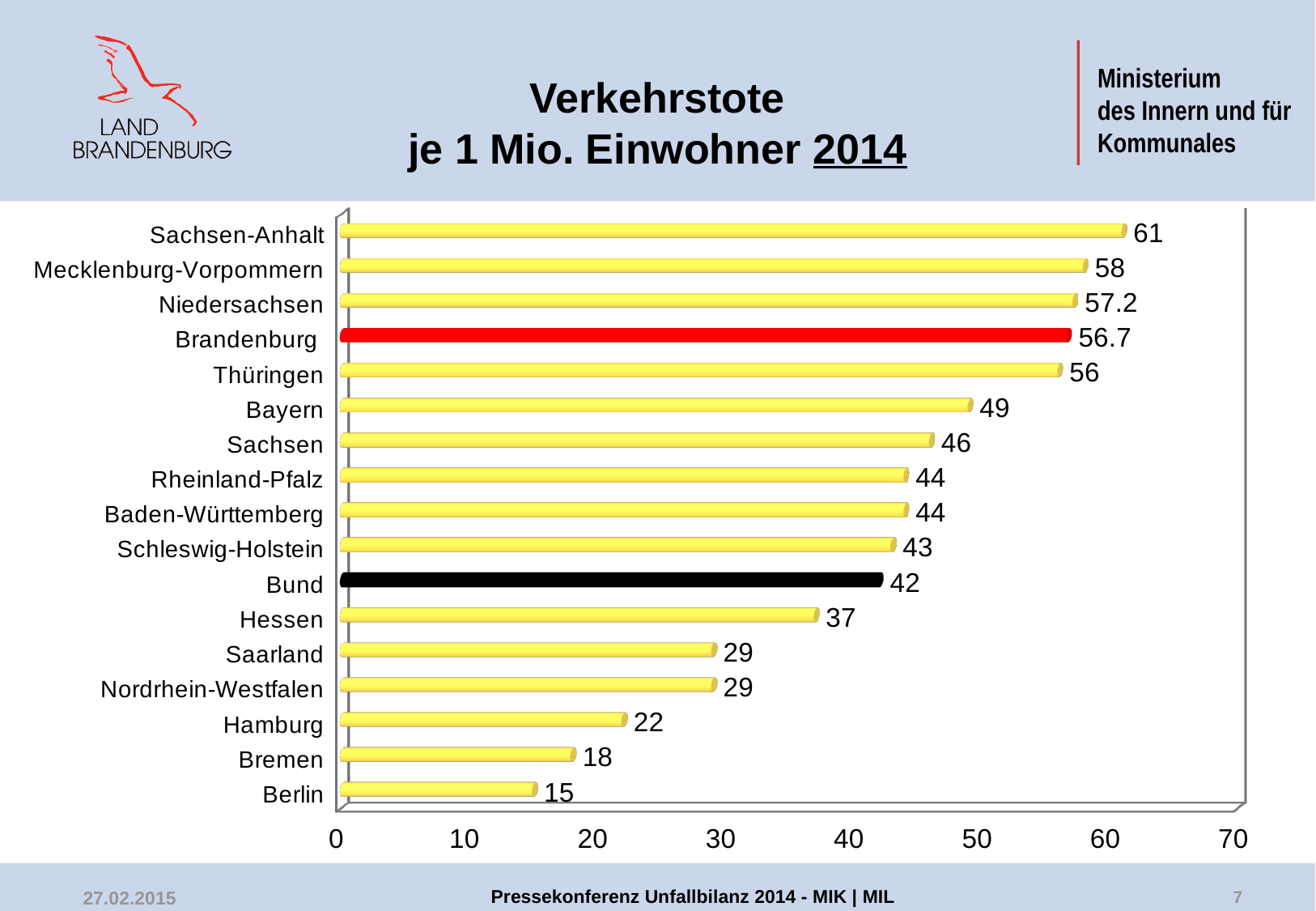
Which is larger, the value for Bayern or the value for Hessen? Bayern How many categories are shown on the chart? 17 Which category has the highest value? Sachsen-Anhalt What is the difference between the values for Sachsen-Anhalt and Berlin? 46 What is the value for Brandenburg? 56.7 What is the difference between the values for Brandenburg and Bund? 14.7 Which bar is coloured red? Brandenburg What is the value for Niedersachsen? 57.2 What kind of chart is shown on the slide? bar chart Is the value for Thüringen greater or less than 50? greater What is the value for Bund? 42 Which category has the lowest value? Berlin